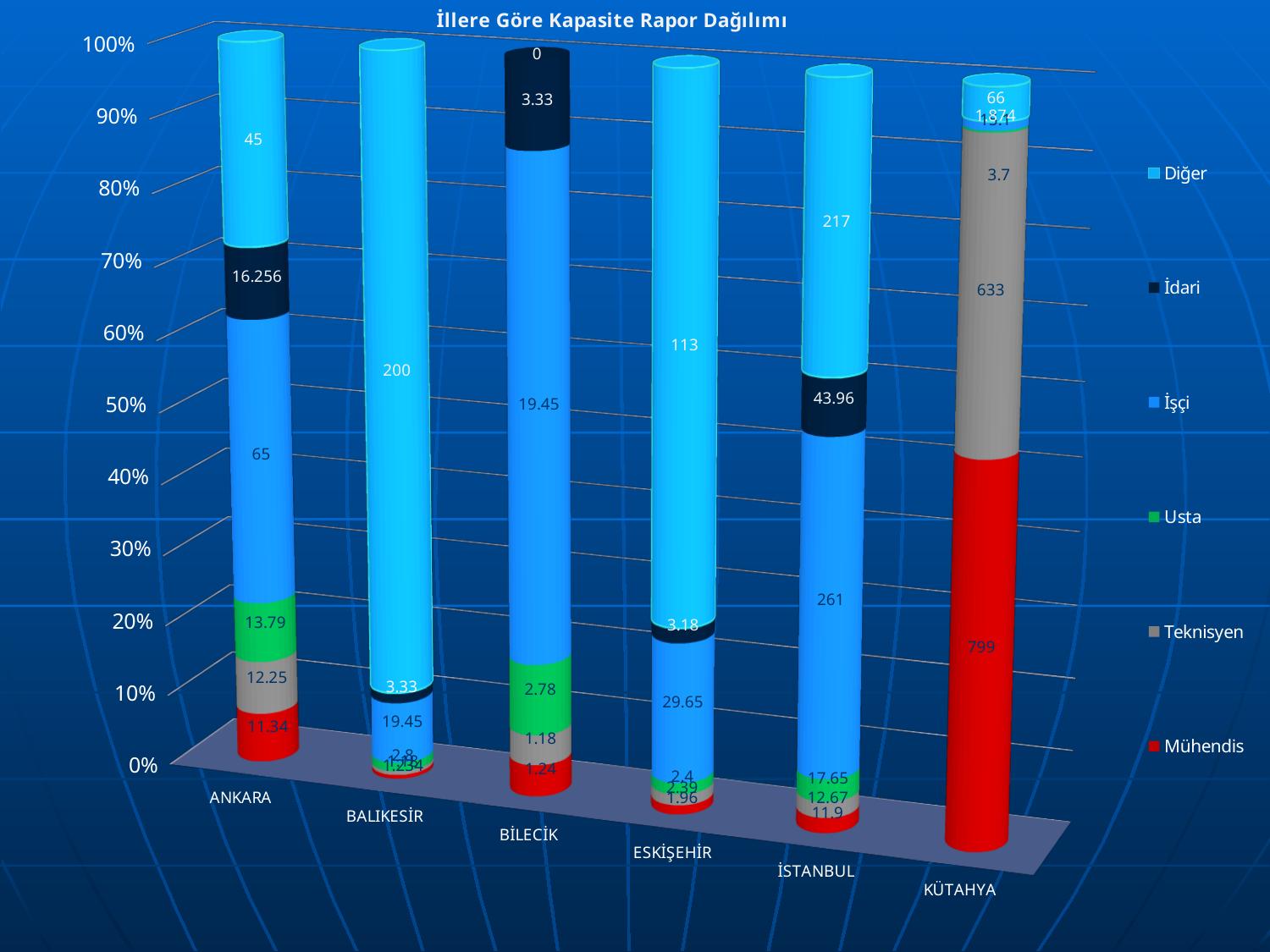
What is the İşçi value for İSTANBUL? 261 What is the İdari value for ANKARA? 16.256 What is the title of the chart? İllere Göre Kapasite Rapor Dağılımı What kind of chart is shown on the slide? Stacked bar chart What is the Mühendis value for KÜTAHYA? 799 How many provinces (categories) are shown on the x axis? 6 What is the Diğer value for BİLECİK? 0 For İSTANBUL, which is larger, the İşçi value or the Diğer value? İşçi What is the difference between the Mühendis value and the Teknisyen value for KÜTAHYA? 166 What is the Diğer value for BALIKESİR? 200 Which series is shown in red in the legend? Mühendis How many series does the legend list? 6